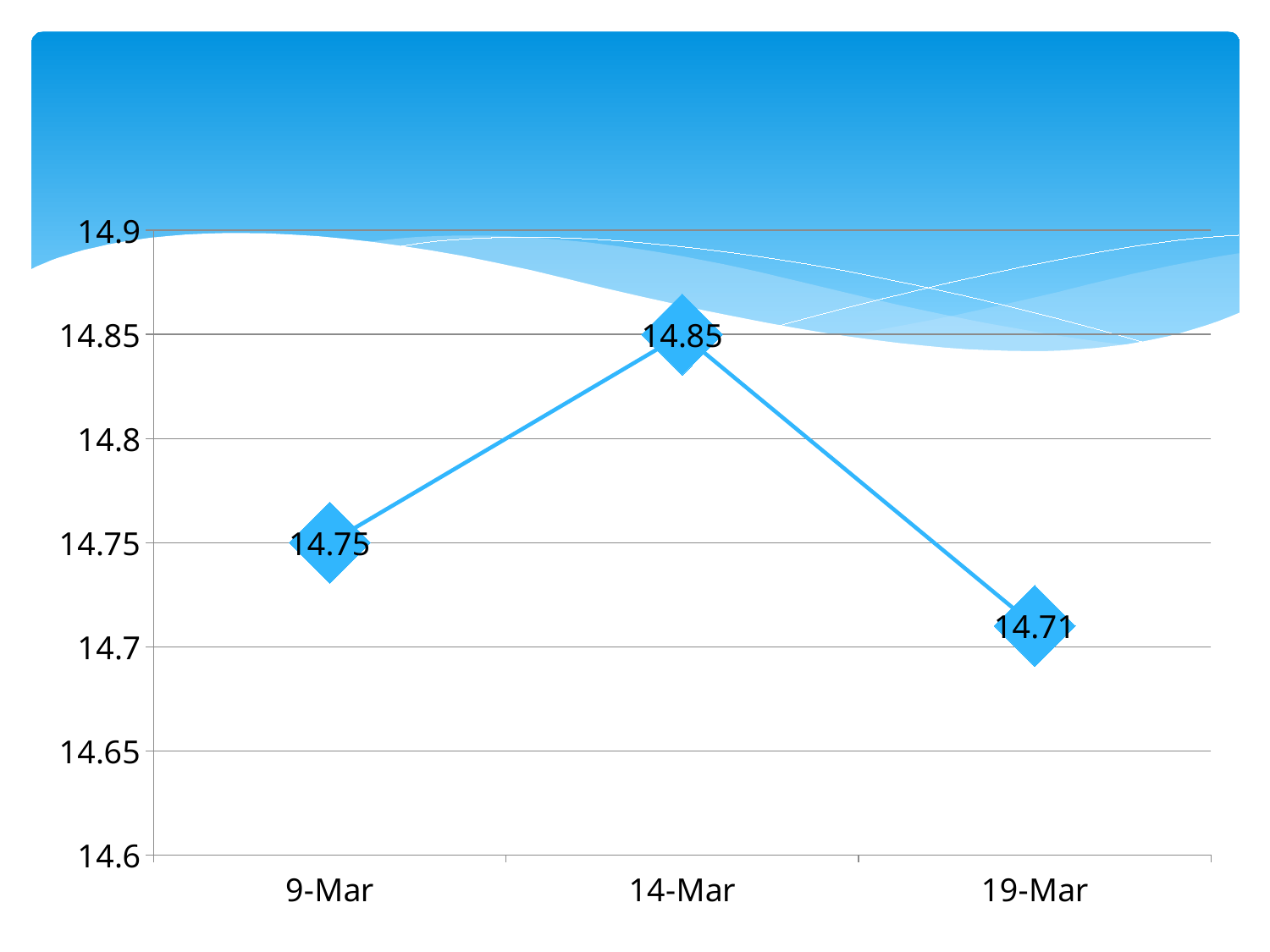
Which is larger, the value for 9-Mar or the value for 19-Mar? 9-Mar What is the difference between the values for 14-Mar and 9-Mar? 0.1 How many data points are plotted on the chart? 3 What is the value for 14-Mar? 14.85 What is the value for 19-Mar? 14.71 What is the difference between the values for 9-Mar and 19-Mar? 0.04 Which date has the highest value? 14-Mar What is the value for 9-Mar? 14.75 Does the value rise or fall from 14-Mar to 19-Mar? fall Which date has the lowest value? 19-Mar What kind of chart is shown on the slide? line chart Is the value for 14-Mar greater or less than 14.8? greater